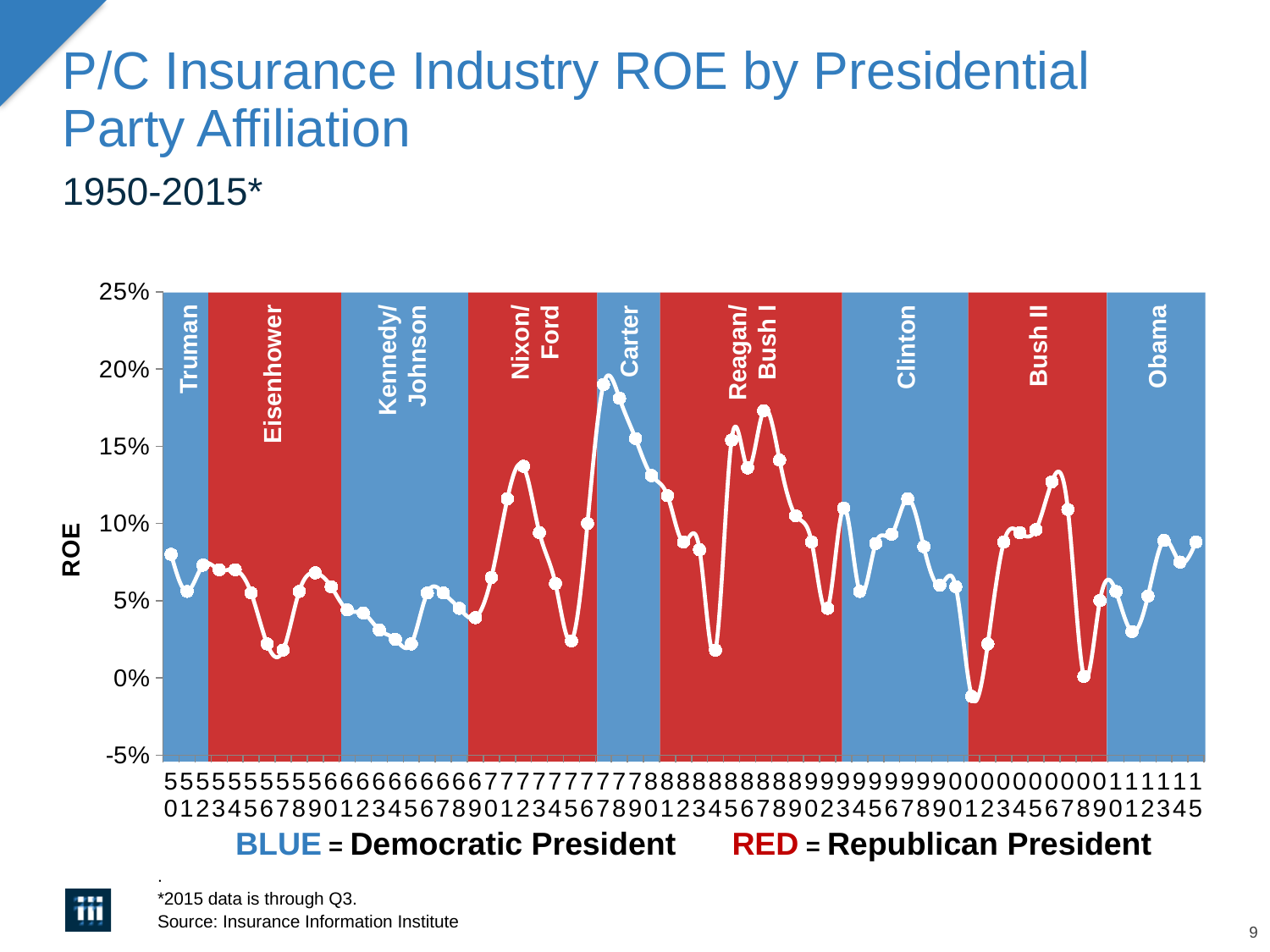
In which year does the P/C insurance industry ROE reach its lowest point on the chart? 2001 What kind of chart is shown on the slide? line chart Is the ROE value for 1987 greater or less than 15%? greater Is the ROE value for 1977 greater or less than 15%? greater Is the ROE value for 1984 greater or less than 5%? less How many presidential administration bands are labeled on the chart? 9 Which year has the higher ROE, 1973 or 1975? 1973 In which year does the P/C insurance industry ROE reach its highest point on the chart? 1977 Does the ROE rise or fall from 1984 to 1987? rise According to the chart's legend, what does the blue shading represent? Democratic President